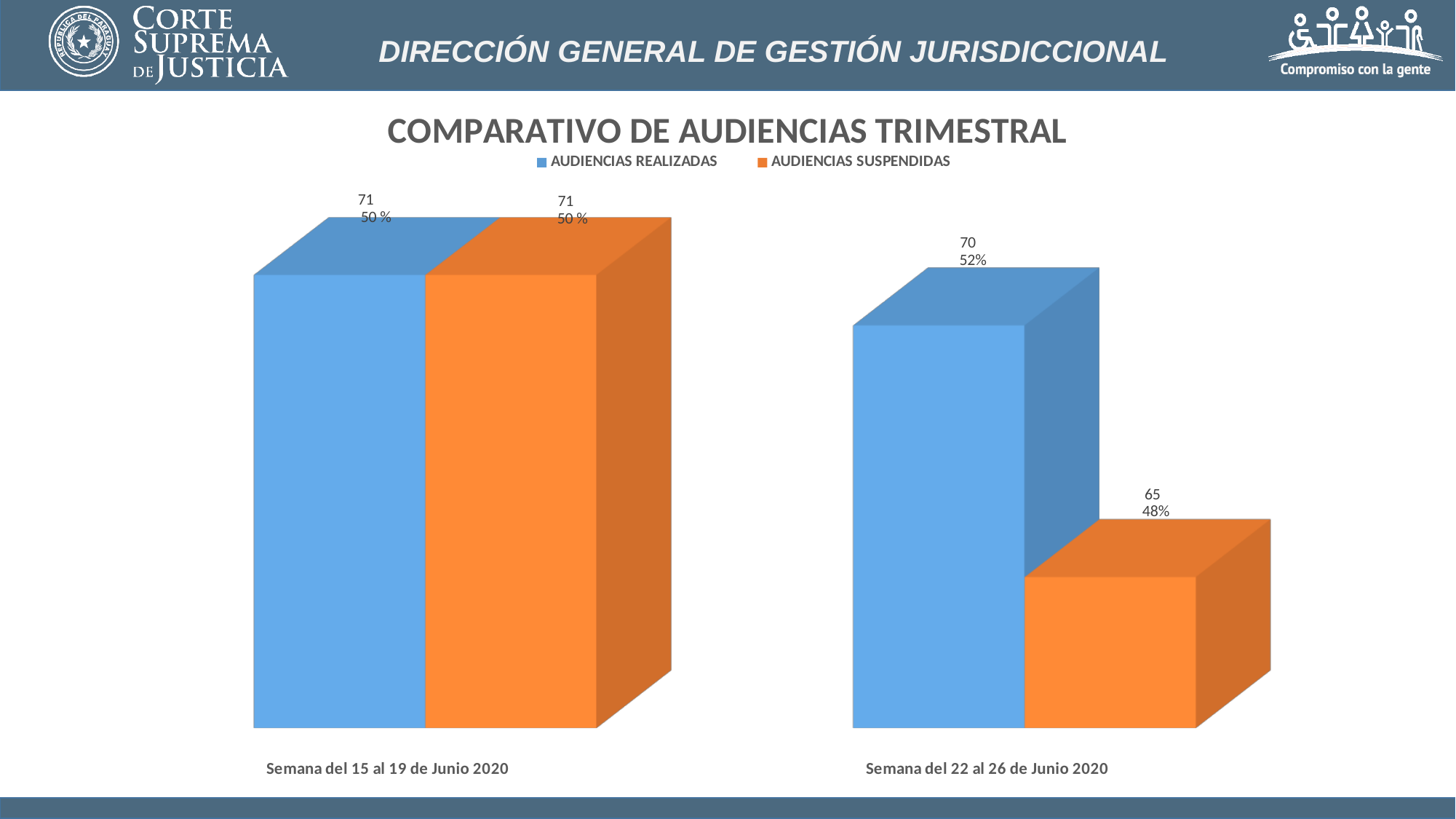
What is the value of AUDIENCIAS REALIZADAS for Semana del 15 al 19 de Junio 2020? 71 What is the value of AUDIENCIAS SUSPENDIDAS for Semana del 22 al 26 de Junio 2020? 65 What percentage is shown for AUDIENCIAS SUSPENDIDAS in Semana del 22 al 26 de Junio 2020? 48% What percentage is shown for AUDIENCIAS REALIZADAS in Semana del 15 al 19 de Junio 2020? 50 % What kind of chart is shown on the slide? Bar chart Which week has the lowest value for AUDIENCIAS SUSPENDIDAS? Semana del 22 al 26 de Junio 2020 How many weeks (categories) are shown on the chart? 2 What is the value of AUDIENCIAS REALIZADAS for Semana del 22 al 26 de Junio 2020? 70 For Semana del 22 al 26 de Junio 2020, which is larger: AUDIENCIAS REALIZADAS or AUDIENCIAS SUSPENDIDAS? AUDIENCIAS REALIZADAS How many series does the legend list? 2 What is the difference between AUDIENCIAS REALIZADAS and AUDIENCIAS SUSPENDIDAS for Semana del 22 al 26 de Junio 2020? 5 What is the title of the chart? COMPARATIVO DE AUDIENCIAS TRIMESTRAL